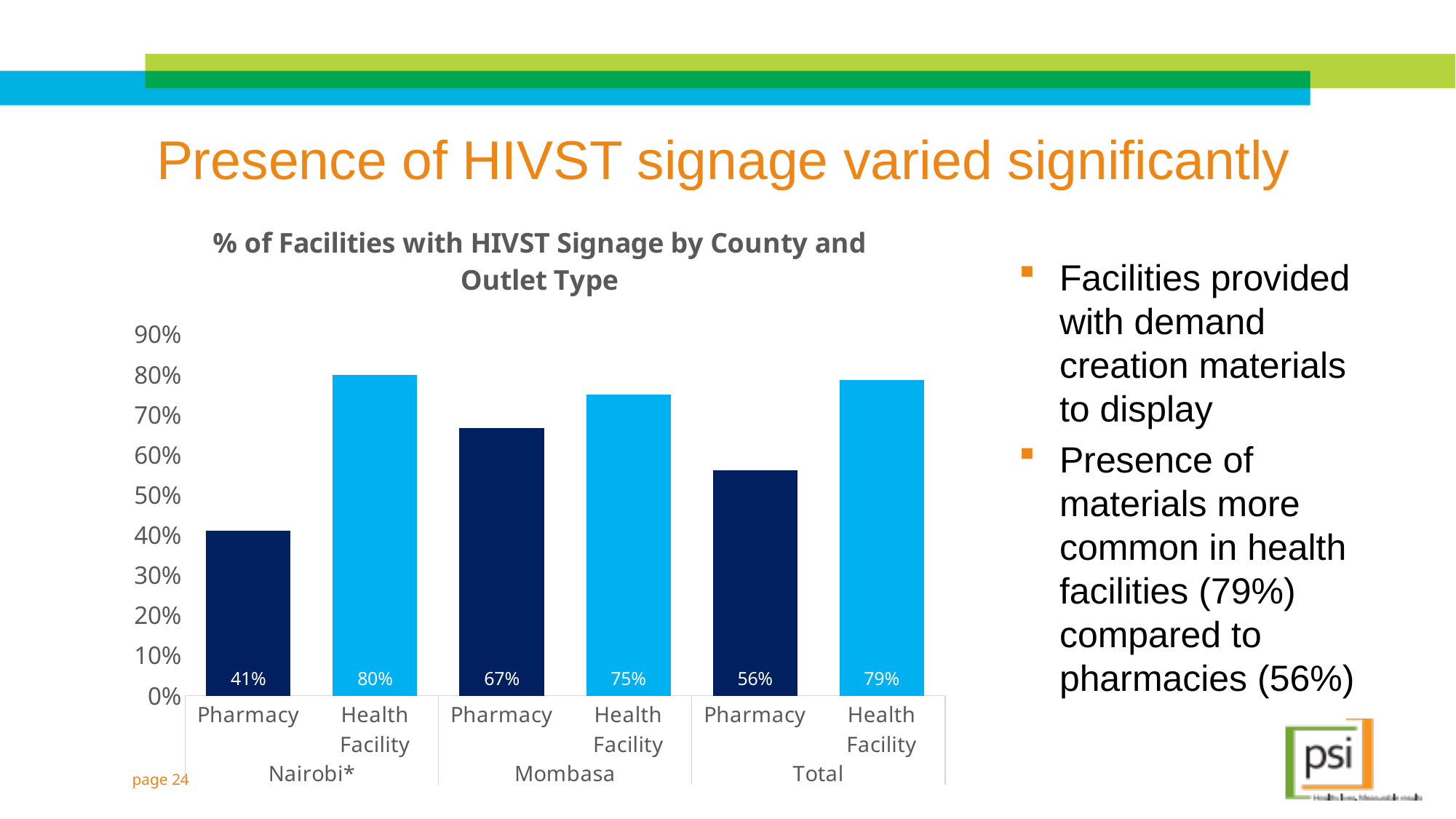
What is the value for Pharmacy in the Total group? 56% Is the value for Pharmacy in Mombasa greater or less than 60%? greater What type of chart is shown on the slide? Bar chart What percentage of pharmacies in Nairobi* had HIVST signage? 41% Which bar has the lowest value in the chart? Pharmacy, Nairobi* (41%) What is the difference between the Health Facility and Pharmacy values in Nairobi*? 39 percentage points Which bar has the highest value in the chart? Health Facility, Nairobi* (80%) How many bars are plotted in the chart? 6 Which is larger: the Pharmacy value in Mombasa or the Pharmacy value in Nairobi*? Mombasa What is the title of the chart? % of Facilities with HIVST Signage by County and Outlet Type What percentage of health facilities in Mombasa had HIVST signage? 75% What is the difference between the Health Facility and Pharmacy values in the Total group? 23 percentage points